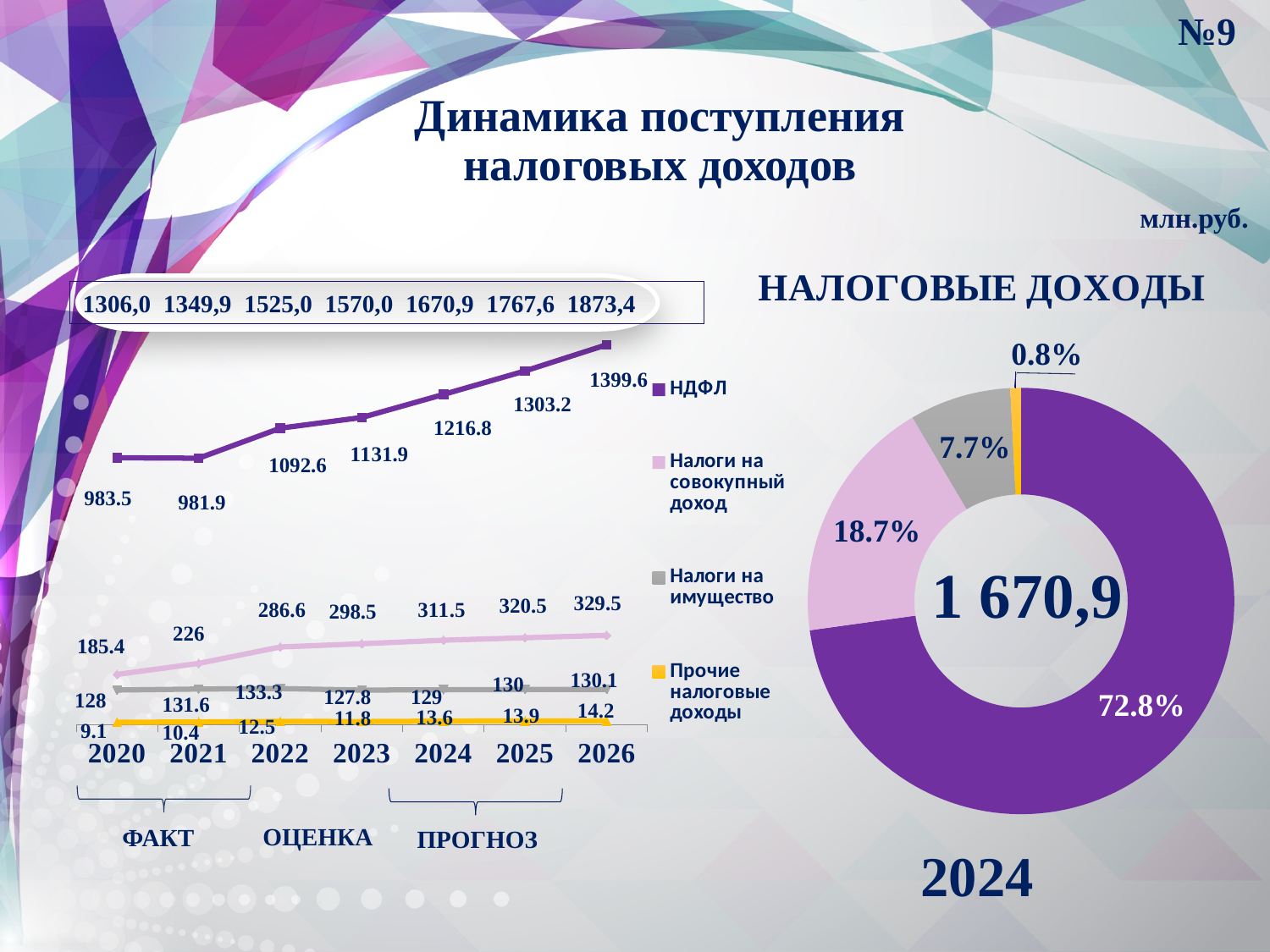
What kind of chart is the chart on the left of the slide? Line chart In the line chart on the left, what is the value for НДФЛ in 2024? 1216.8 In the line chart on the left, in which year is Налоги на имущество lowest? 2023 In the line chart on the left, what is the difference between the НДФЛ values for 2026 and 2020? 416.1 In the line chart on the left, how many years are shown on the x axis? 7 In the line chart on the left, which year has the larger value for Налоги на имущество, 2021 or 2022? 2022 In the line chart on the left, in which year is НДФЛ highest? 2026 In the line chart on the left, does the value for Налоги на совокупный доход rise or fall from 2020 to 2026? Rise In the line chart on the left, what is the value for Прочие налоговые доходы in 2020? 9.1 In the line chart on the left, what is the value for Налоги на совокупный доход in 2026? 329.5 In the line chart on the left, how many series does the legend list? 4 In the doughnut chart НАЛОГОВЫЕ ДОХОДЫ on the right, what share does the largest slice have? 72.8%